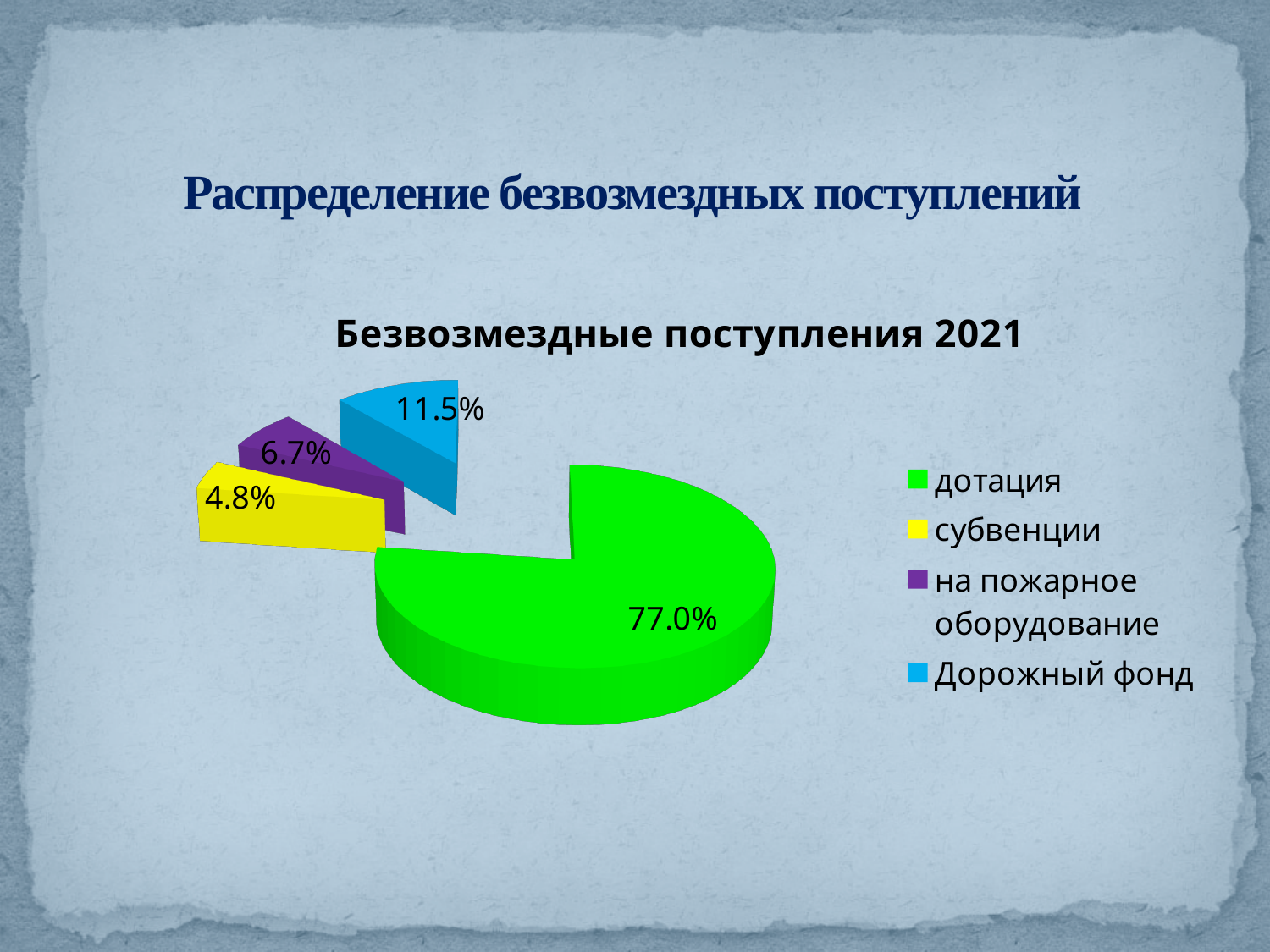
Which category has the smallest share of the pie? субвенции Which is larger, the share of на пожарное оборудование or the share of субвенции? на пожарное оборудование What share of the pie does Дорожный фонд have? 11.5% What colour is the slice for Дорожный фонд? Blue What share of the pie does на пожарное оборудование have? 6.7% What is the difference between the shares of Дорожный фонд and на пожарное оборудование? 4.8% What type of chart is shown on the slide? Pie chart What is the title of the chart? Безвозмездные поступления 2021 How many categories does the pie chart show? 4 What share of the pie does субвенции have? 4.8% What share of the pie does дотация have? 77.0% Which category has the largest share of the pie? дотация